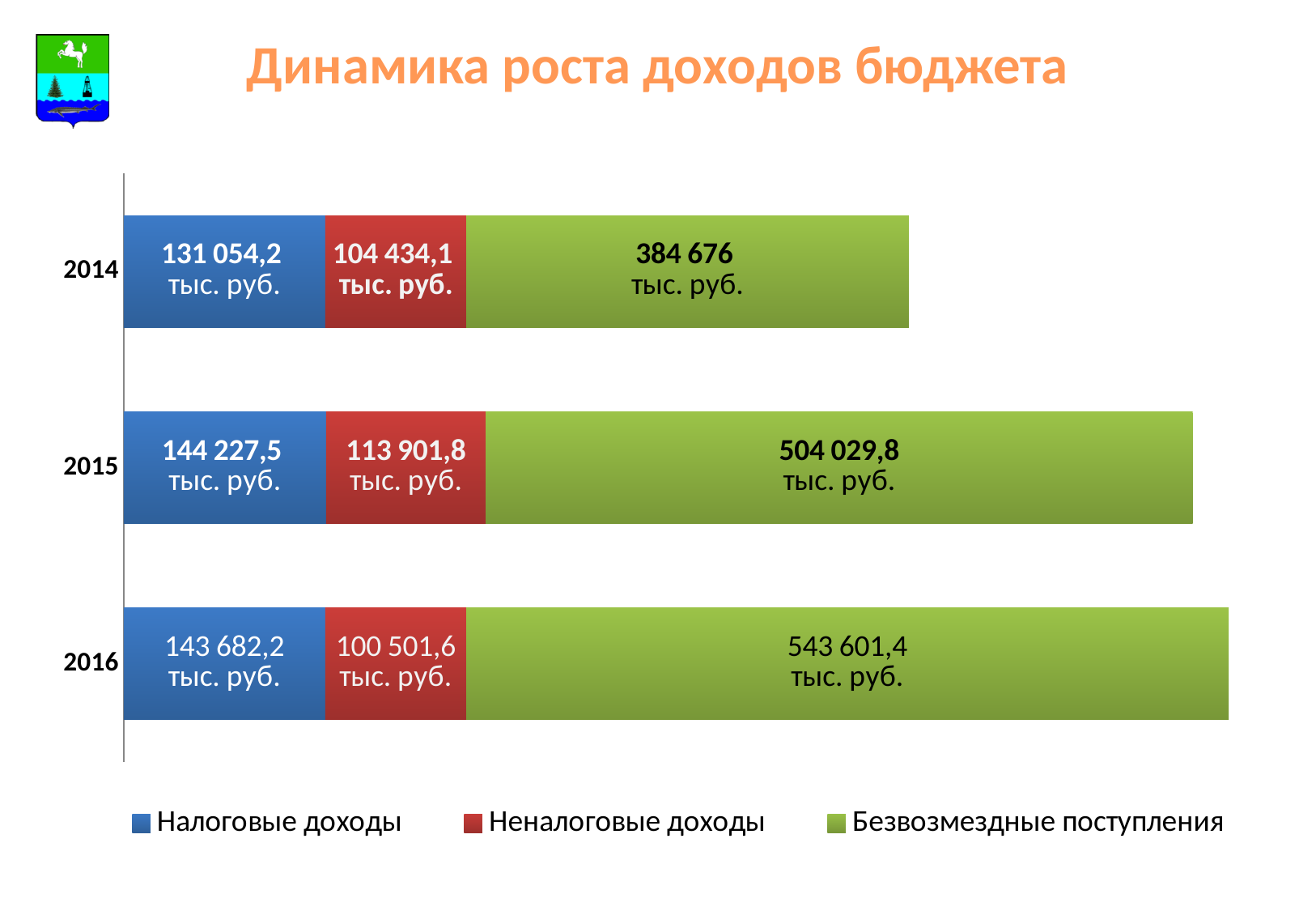
What is the difference between Безвозмездные поступления in 2016 and in 2015? 39 571,6 тыс. руб. How many years (categories) are shown in the chart? 3 What is the value of Неналоговые доходы for 2016? 100 501,6 тыс. руб. What is the title of the chart? Динамика роста доходов бюджета What is the value of Безвозмездные поступления for 2015? 504 029,8 тыс. руб. In which year are Безвозмездные поступления the highest? 2016 What is the value of Налоговые доходы for 2014? 131 054,2 тыс. руб. Which is larger: Налоговые доходы in 2015 or in 2016? 2015 What type of chart is shown on the slide? Stacked bar chart How many series does the legend list? 3 What is the total of the stacked bar for 2014? 620 164,3 тыс. руб. In which year are Неналоговые доходы the lowest? 2016